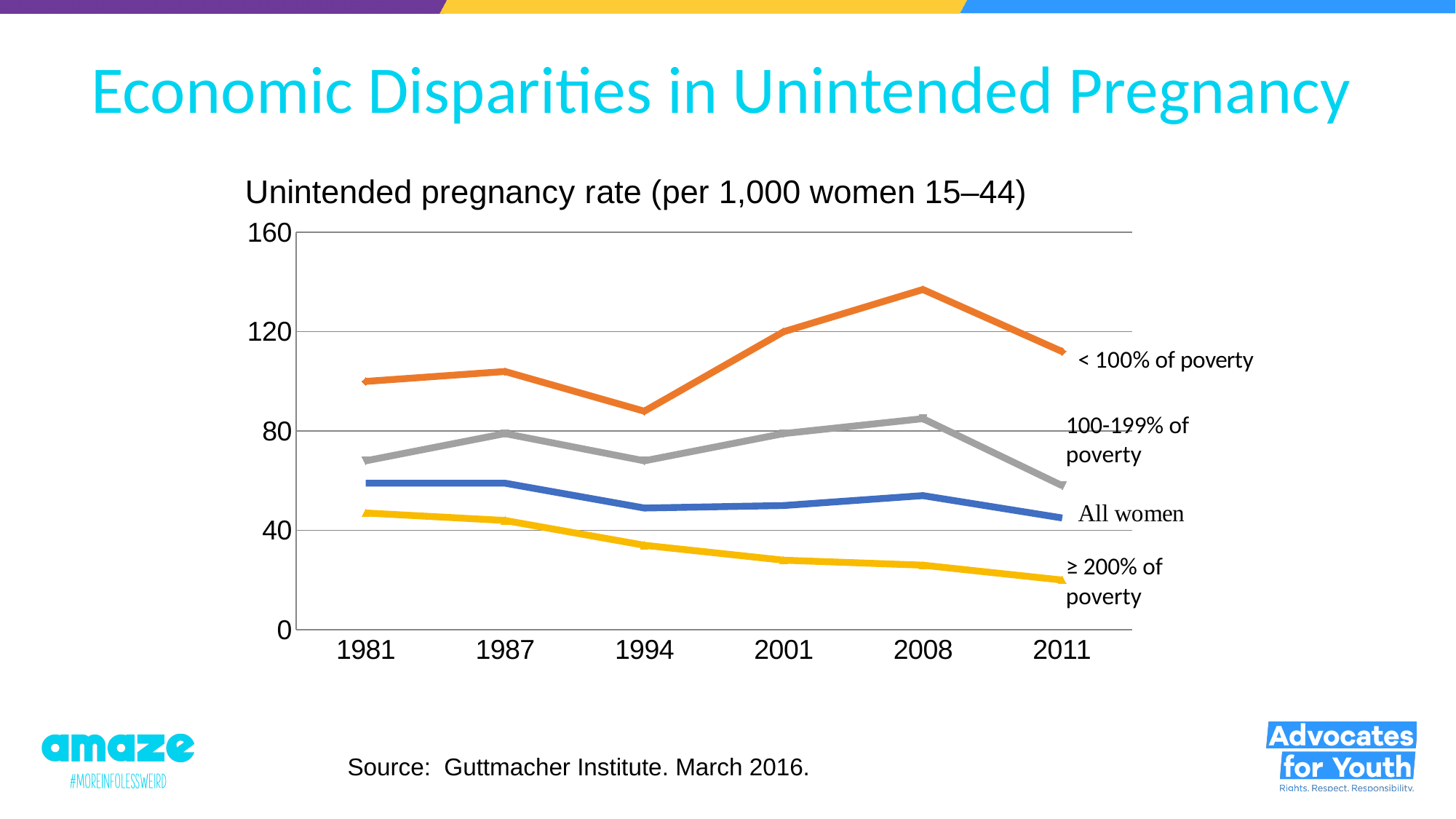
Which series has the highest values across all years shown? < 100% of poverty In which year does the < 100% of poverty series reach its highest value? 2008 In which year does the ≥ 200% of poverty series reach its lowest value? 2011 How many series are plotted on the chart? 4 What kind of chart is shown on the slide? line chart How many years are shown on the x axis of the chart? 6 What is the title of the chart? Unintended pregnancy rate (per 1,000 women 15–44) In 2011, which is higher: 100-199% of poverty or All women? 100-199% of poverty Is the value for All women in 1981 greater or less than 40? greater Is the value for ≥ 200% of poverty in 2011 greater or less than 40? less Is the value for < 100% of poverty in 2008 greater or less than 120? greater Does the ≥ 200% of poverty series rise or fall from 1981 to 2011? fall